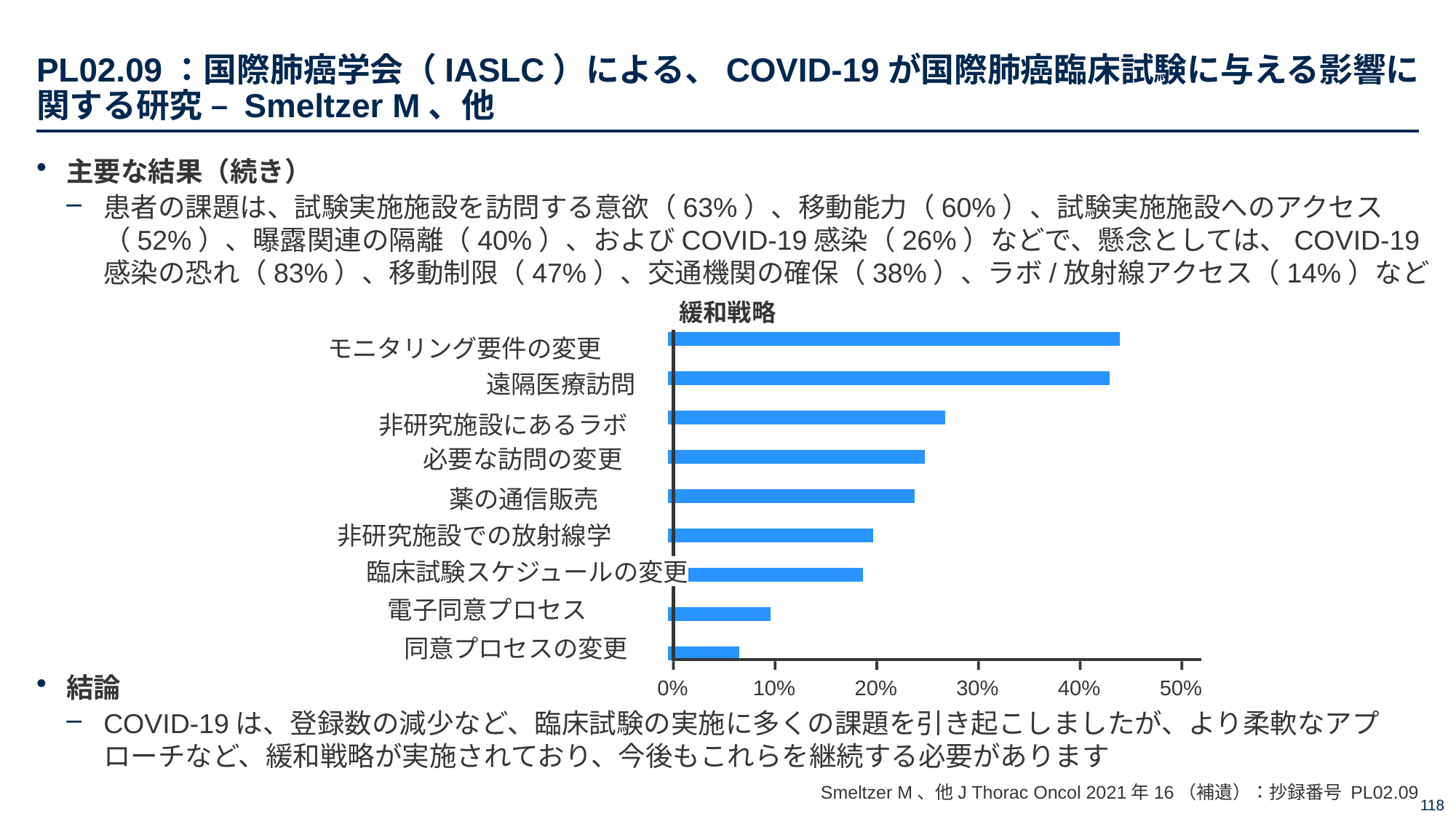
What is the title of the chart? 緩和戦略 How many categories are plotted in the chart? 9 Which category has the lowest value in the chart? 同意プロセスの変更 Which has a larger value, 電子同意プロセス or 同意プロセスの変更? 電子同意プロセス Which has a larger value, 非研究施設にあるラボ or 薬の通信販売? 非研究施設にあるラボ Is the value for 遠隔医療訪問 greater or less than 40%? greater Is the value for 薬の通信販売 greater or less than 20%? greater Do the bar values increase or decrease going from the top category to the bottom category? decrease Is the value for モニタリング要件の変更 greater or less than 40%? greater What kind of chart is shown on the slide? bar chart